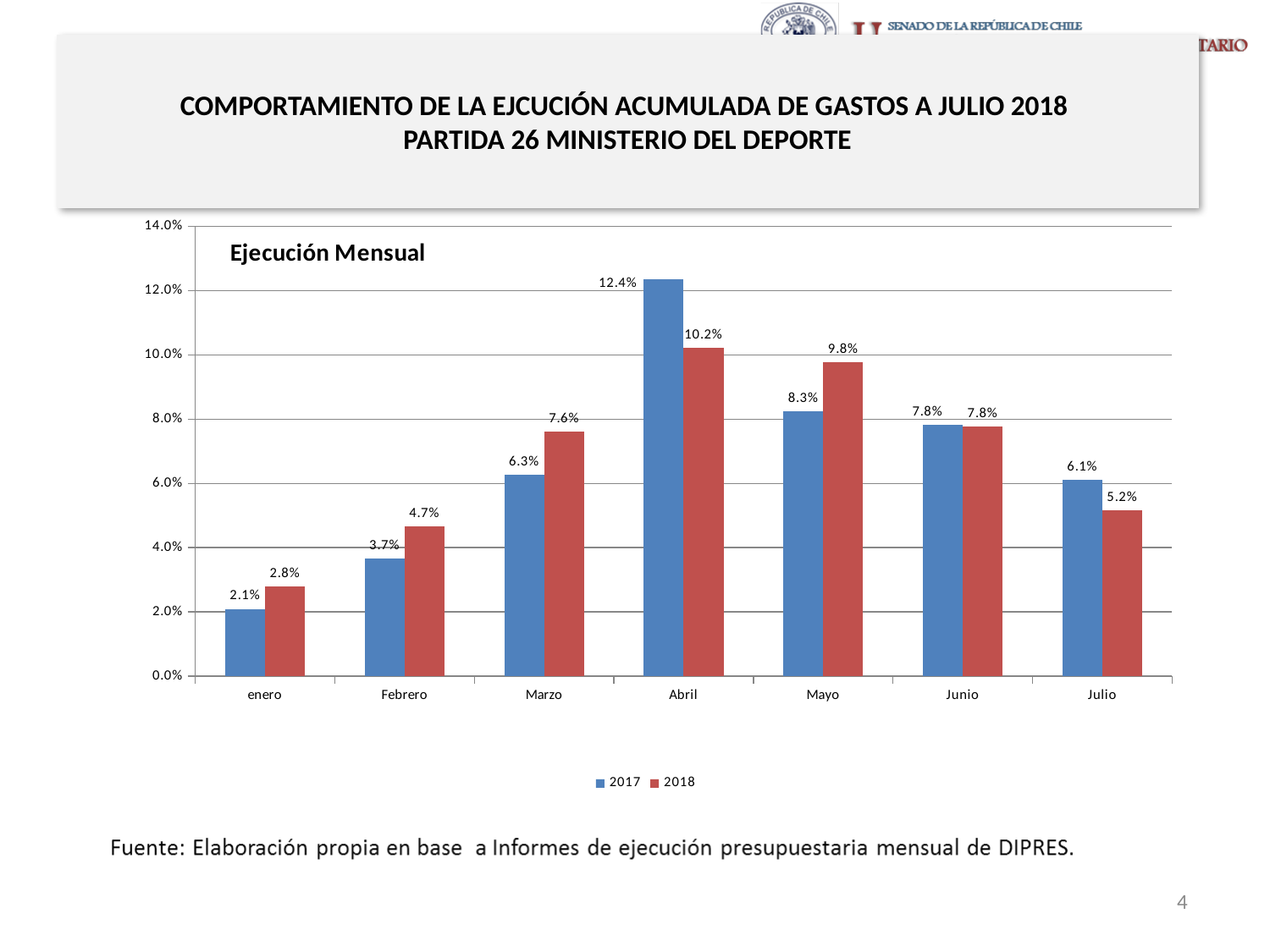
What is the value for 2017 in Julio? 6.1% How many series does the legend list? 2 What is the difference between the 2017 and 2018 values in Abril? 2.2 percentage points Which is larger in Mayo, the 2017 value or the 2018 value? 2018 Which month has the highest value for the 2017 series? Abril What is the value for 2018 in Mayo? 9.8% How many months are shown on the x axis? 7 What is the value for 2018 in enero? 2.8% What is the value for 2017 in Abril? 12.4% What kind of chart is shown on the slide? Bar chart Which month has the lowest value for the 2018 series? enero What is the title of the chart? Ejecución Mensual